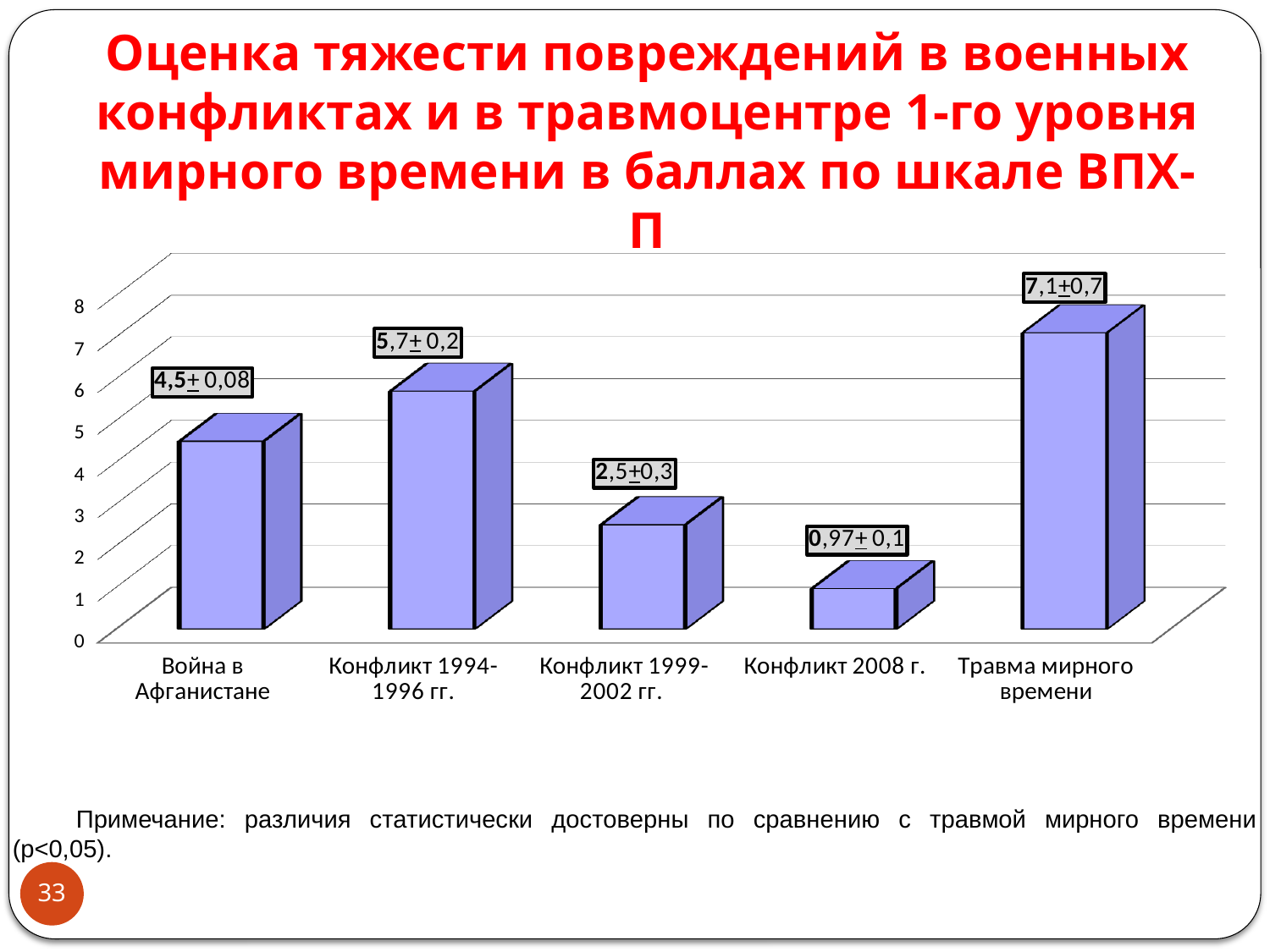
What is the difference between the mean values for Конфликт 1994-1996 гг. (5,7) and Война в Афганистане (4,5)? 1,2 What value is labelled on the bar for Конфликт 2008 г.? 0,97±0,1 Which category has the lowest bar? Конфликт 2008 г. Is the value for Конфликт 1999-2002 гг. greater or less than 3? less Which category has the highest bar? Травма мирного времени What kind of chart is shown on the slide? bar chart What value is labelled on the bar for Конфликт 1999-2002 гг.? 2,5±0,3 Which is larger: the value for Конфликт 1994-1996 гг. or the value for Война в Афганистане? Конфликт 1994-1996 гг. What value is labelled on the bar for Травма мирного времени? 7,1±0,7 What value is labelled on the bar for Конфликт 1994-1996 гг.? 5,7±0,2 How many categories are shown on the x axis? 5 What value is labelled on the bar for Война в Афганистане? 4,5±0,08